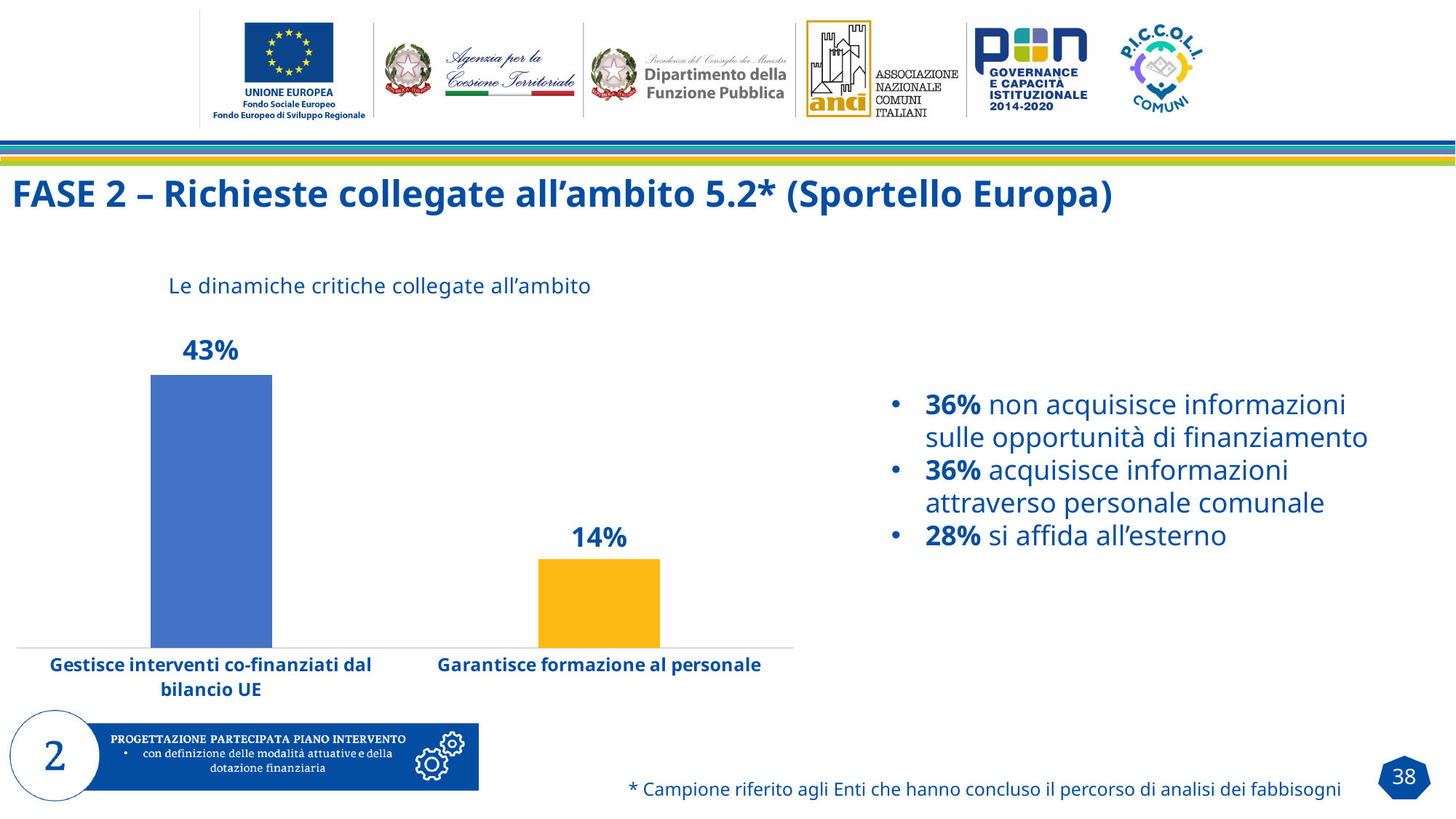
Which category has the lowest value? Garantisce formazione al personale What is the value for "Garantisce formazione al personale"? 14% What colour is the bar for "Garantisce formazione al personale"? Yellow What is the difference between the values for "Gestisce interventi co-finanziati dal bilancio UE" and "Garantisce formazione al personale"? 29% How many categories are shown in the chart? 2 What is the value for "Gestisce interventi co-finanziati dal bilancio UE"? 43% What kind of chart is shown on the slide? Bar chart What is the title of the chart? Le dinamiche critiche collegate all'ambito Which category has the highest value? Gestisce interventi co-finanziati dal bilancio UE Which is larger: the value for "Gestisce interventi co-finanziati dal bilancio UE" or for "Garantisce formazione al personale"? Gestisce interventi co-finanziati dal bilancio UE